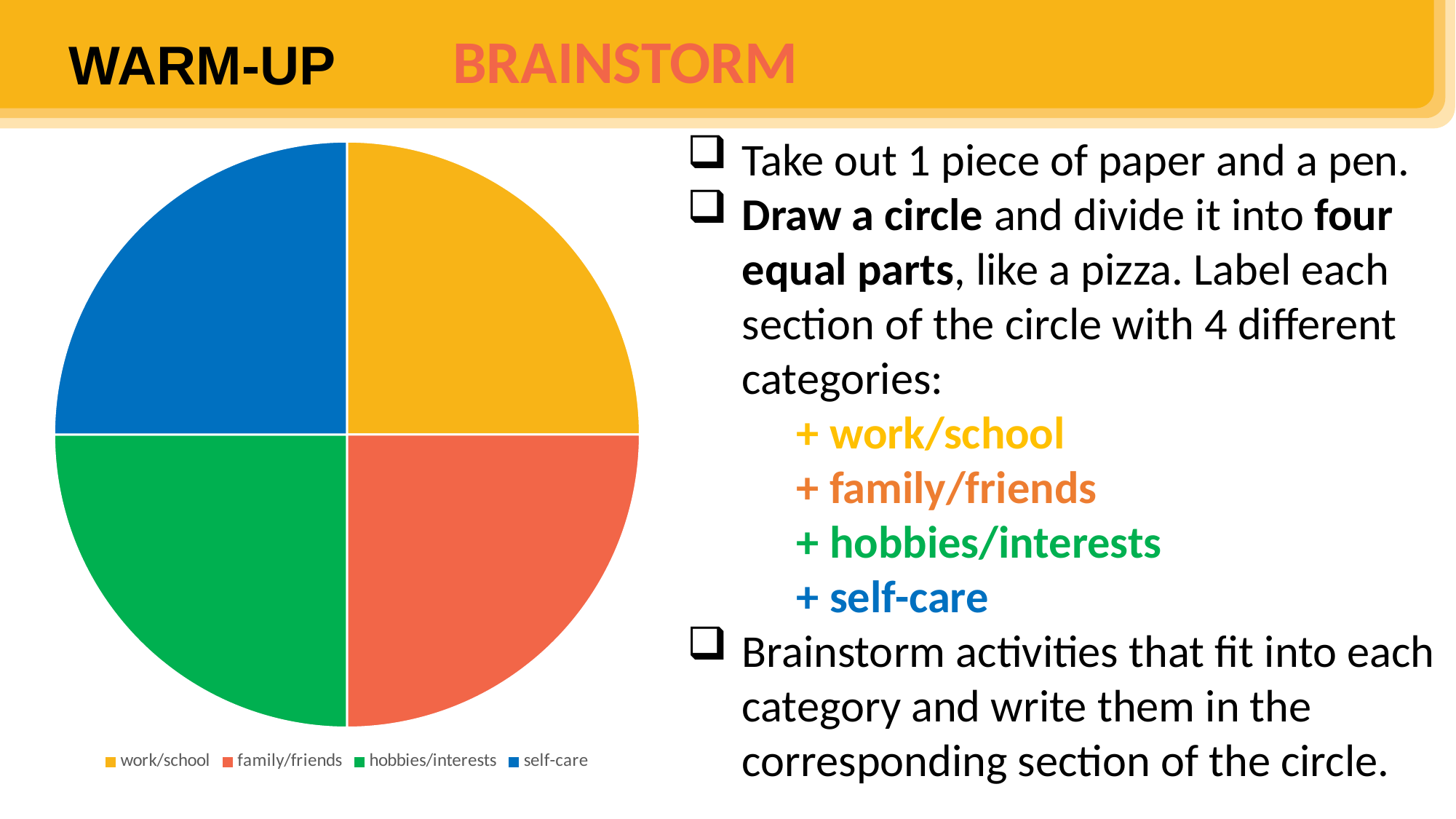
What kind of chart is shown on the left of the slide? pie chart Which category does the blue slice of the pie chart represent? self-care How many entries does the pie chart's legend list? 4 Which category is listed last in the pie chart's legend? self-care Which category does the yellow slice of the pie chart represent? work/school Which category is listed first in the pie chart's legend? work/school What share of the pie chart does the hobbies/interests slice take up, given the slide says the circle is divided into four equal parts? 25% How many slices does the pie chart have? 4